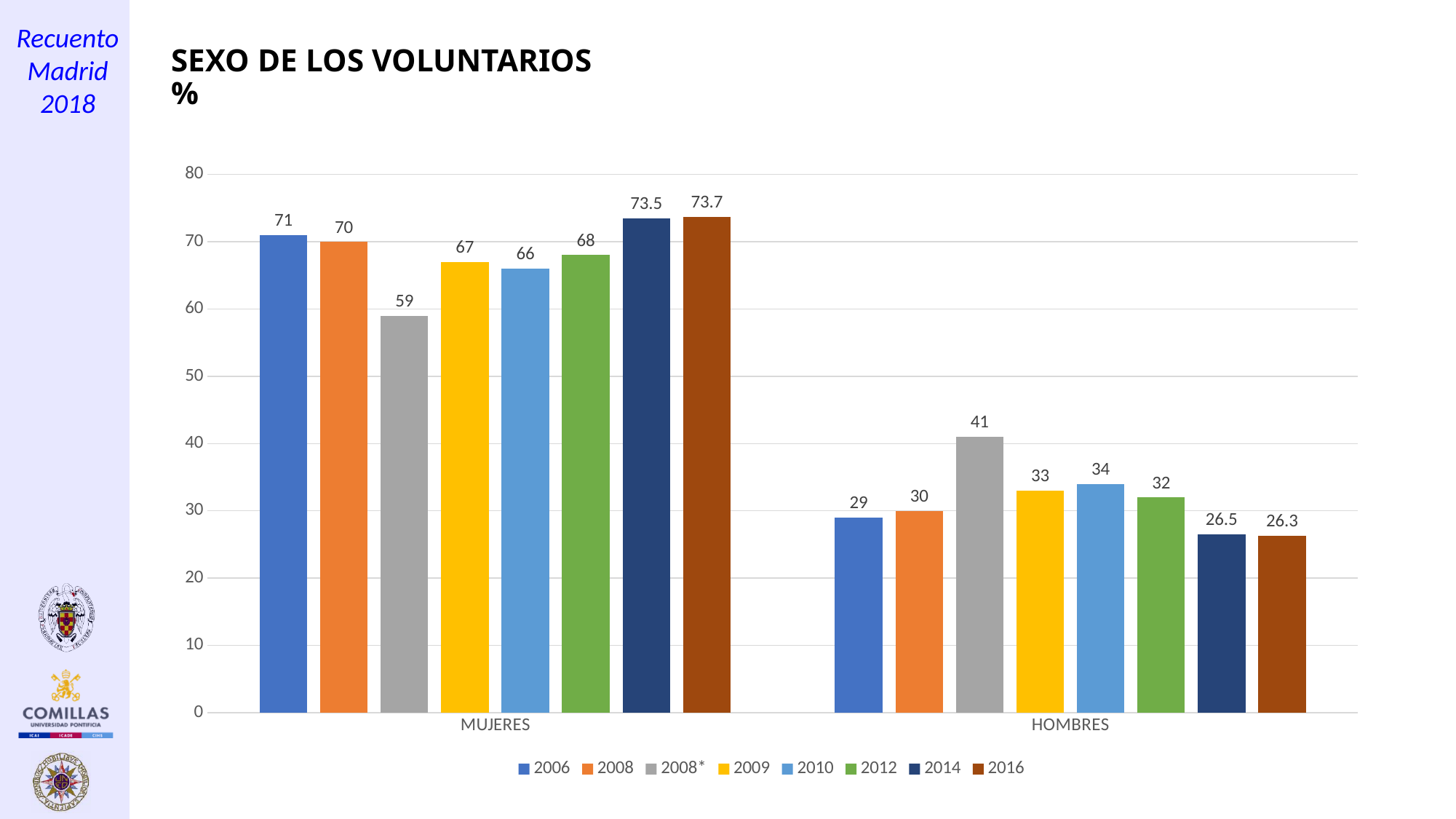
What is the value for HOMBRES in the 2008* series? 41 What is the value for HOMBRES in the 2014 series? 26.5 Is the value for MUJERES in the 2008* series greater or less than 60? less Which series has the highest value for HOMBRES? 2008* What kind of chart is shown on the slide? bar chart What is the title of the chart? SEXO DE LOS VOLUNTARIOS % What is the value for MUJERES in the 2016 series? 73.7 How many categories are shown on the x axis? 2 Which is larger: the HOMBRES value for 2010 or for 2012? 2010 What is the difference between the MUJERES and HOMBRES values in the 2006 series? 42 Which series has the lowest value for MUJERES? 2008* How many series does the legend list? 8